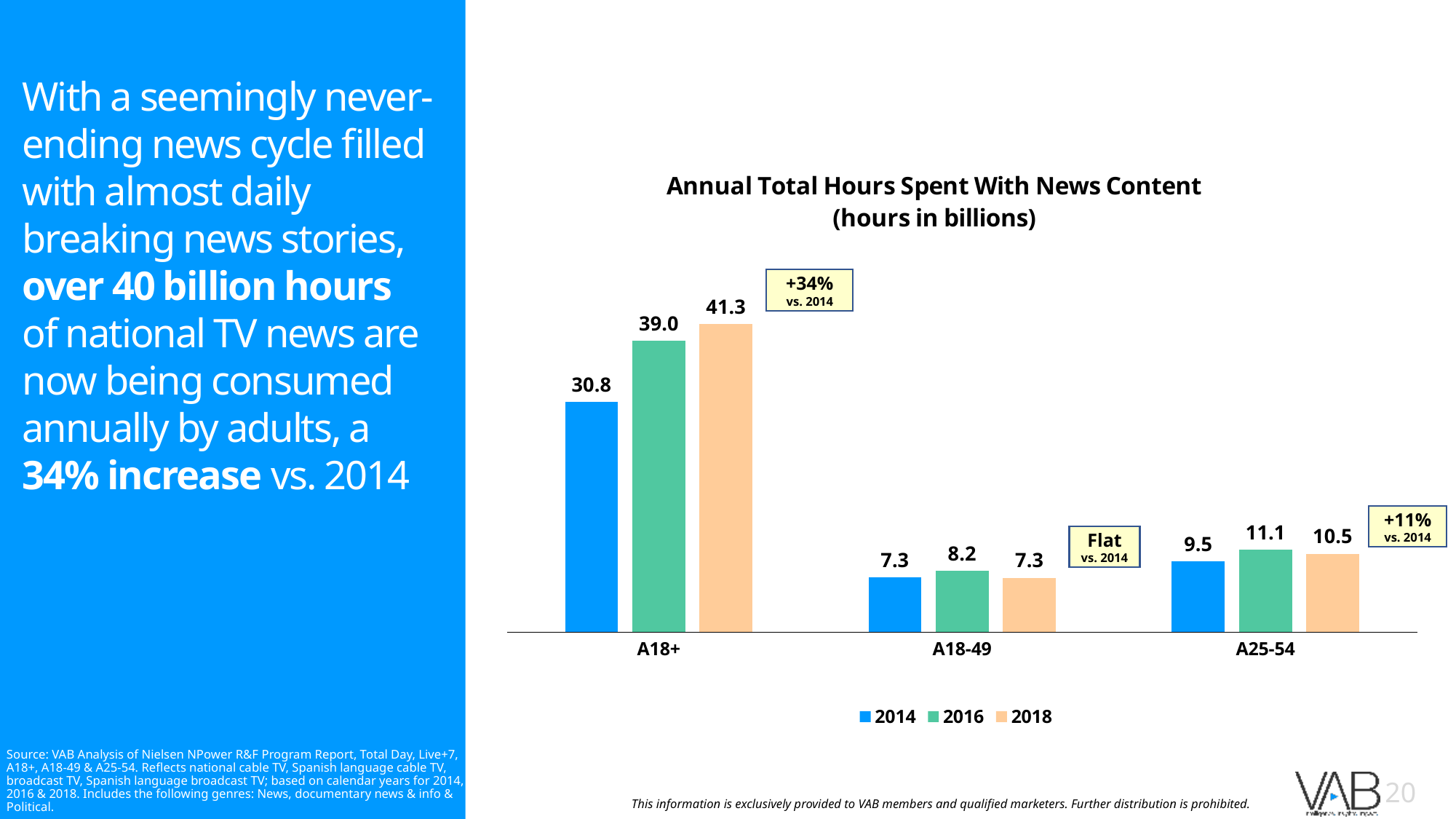
How many series does the legend list? 3 What kind of chart is shown? Bar chart What is the value for A18+ in 2018? 41.3 What is the value for A25-54 in 2014? 9.5 What is the title of the chart? Annual Total Hours Spent With News Content (hours in billions) Which age group has the lowest value in 2014? A18-49 How many age groups are shown on the x axis? 3 What is the value for A18-49 in 2016? 8.2 What is the difference between the 2018 and 2014 values for A18+? 10.5 Which is larger for A25-54: the 2016 value or the 2018 value? 2016 Which age group has the highest value in 2018? A18+ Do the values for A18+ rise or fall from 2014 to 2018? Rise